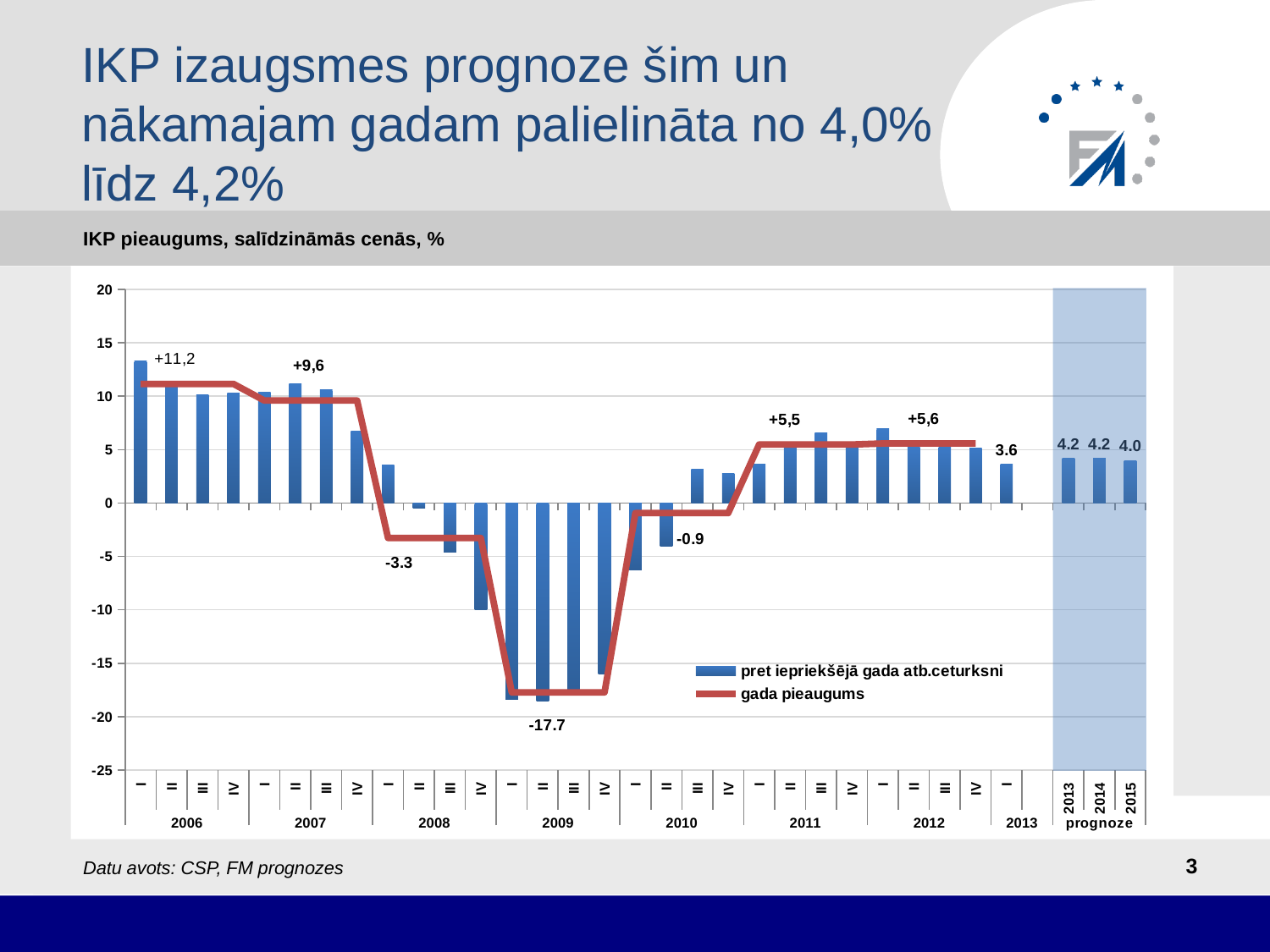
What is the forecast GDP growth value shown for 2015? 4.0 What is the annual GDP growth (gada pieaugums) shown for 2012? +5,6 What is the label of the series drawn as a red line in the legend? gada pieaugums Is the value of the bar for quarter I of 2006 greater or less than 10? greater What is the annual GDP growth (gada pieaugums) shown for 2006? +11,2 What is the annual GDP growth (gada pieaugums) shown for 2009? -17.7 Which year has the lowest annual GDP growth (gada pieaugums) on the chart? 2009 Which year has the highest annual GDP growth (gada pieaugums) on the chart? 2006 How many series does the legend list? 2 What kind of chart is shown on the slide? Combined bar and line chart Which is larger: the annual GDP growth for 2007 or for 2011? 2007 What is the difference between the annual GDP growth for 2012 (+5,6) and 2011 (+5,5)? 0,1